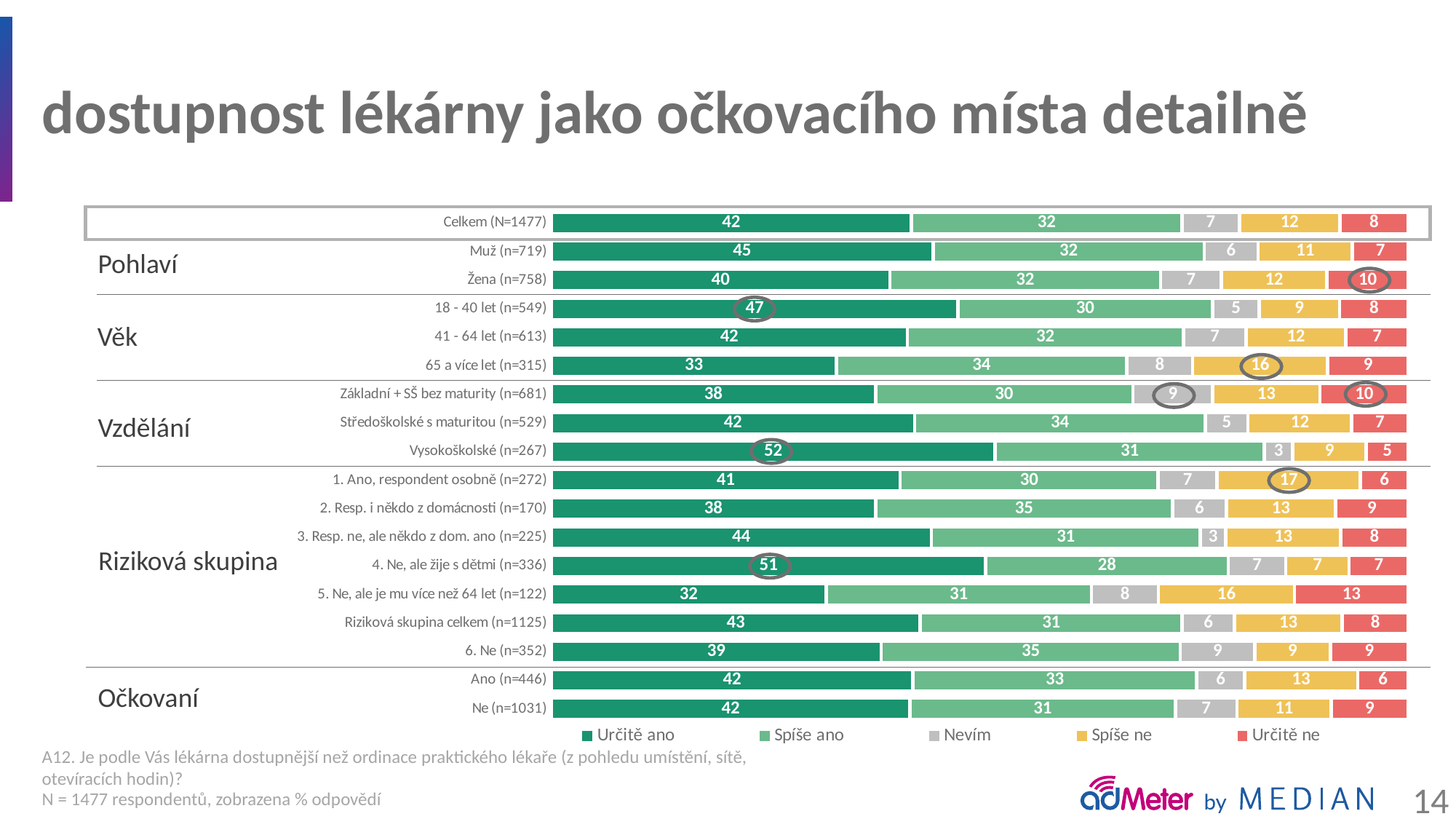
What is the value of "Určitě ano" for Celkem (N=1477)? 42 Which has a larger "Spíše ano" value: 2. Resp. i někdo z domácnosti (n=170) or 4. Ne, ale žije s dětmi (n=336)? 2. Resp. i někdo z domácnosti (n=170) How many series does the legend list? 5 How many categories (rows) are plotted in the chart? 18 Which category has the highest value for "Určitě ano"? Vysokoškolské (n=267) Which category has the highest value for "Určitě ne"? 5. Ne, ale je mu více než 64 let (n=122) What is the value of "Spíše ne" for 65 a více let (n=315)? 16 Which category has the lowest value for "Určitě ano"? 5. Ne, ale je mu více než 64 let (n=122) What is the combined value of "Určitě ano" and "Spíše ano" for Vysokoškolské (n=267)? 83 What is the difference between the "Určitě ano" values for Muž (n=719) and Žena (n=758)? 5 What kind of chart is shown on the slide? Stacked bar chart What is the value of "Určitě ne" for Žena (n=758)? 10